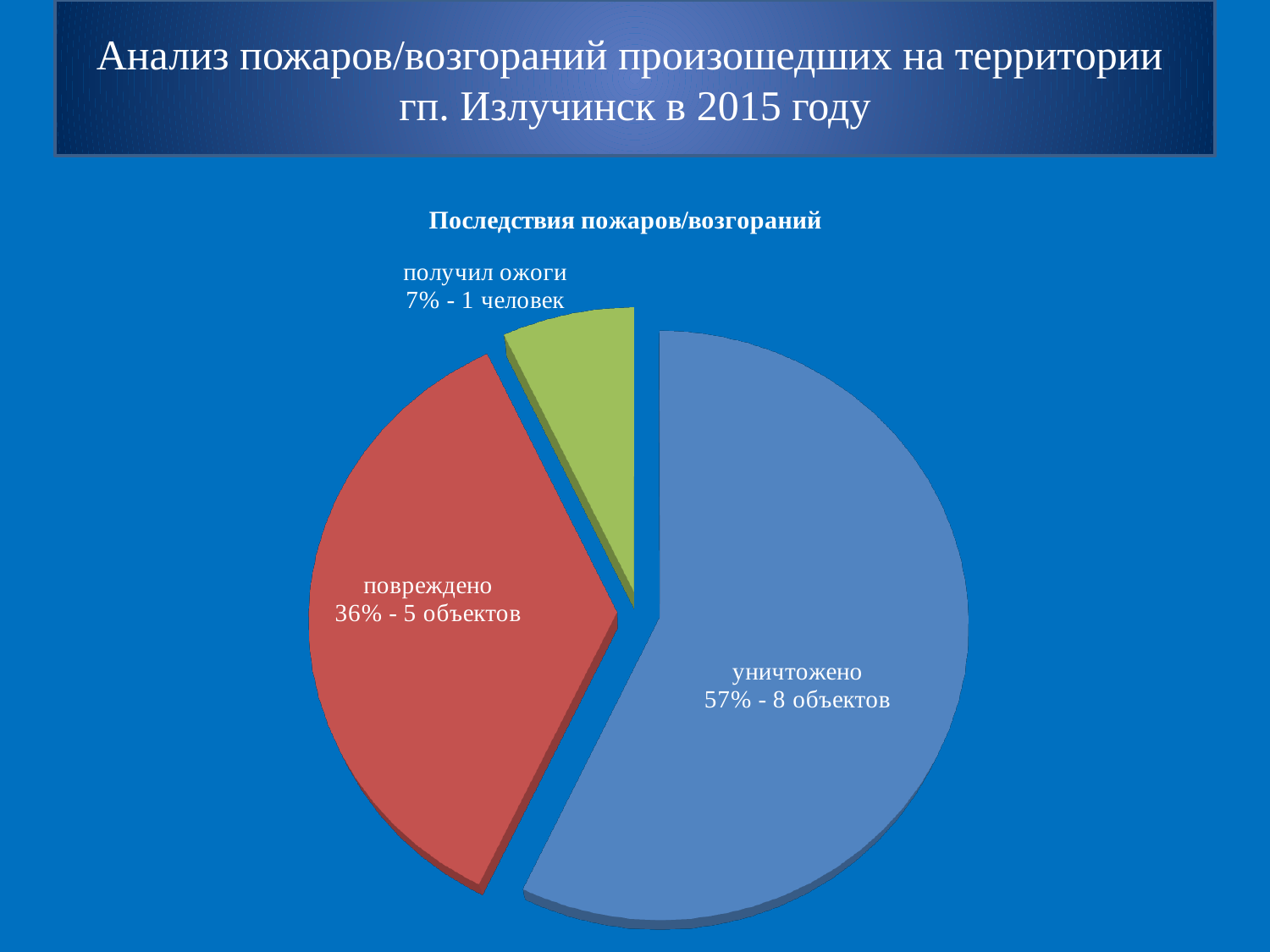
How many slices does the pie chart have? 3 What share of the pie does the slice "повреждено" represent? 36% What share of the pie does the slice "получил ожоги" represent? 7% Which slice of the pie is the smallest? получил ожоги Which slice of the pie is the largest? уничтожено What kind of chart is shown on the slide? pie chart How many objects are labelled as "повреждено"? 5 объектов What is the title of the chart? Последствия пожаров/возгораний What share of the pie does the slice "уничтожено" represent? 57% How many people are labelled as "получил ожоги"? 1 человек How many objects are labelled as "уничтожено"? 8 объектов What is the difference in percentage points between the "уничтожено" and "повреждено" slices? 21